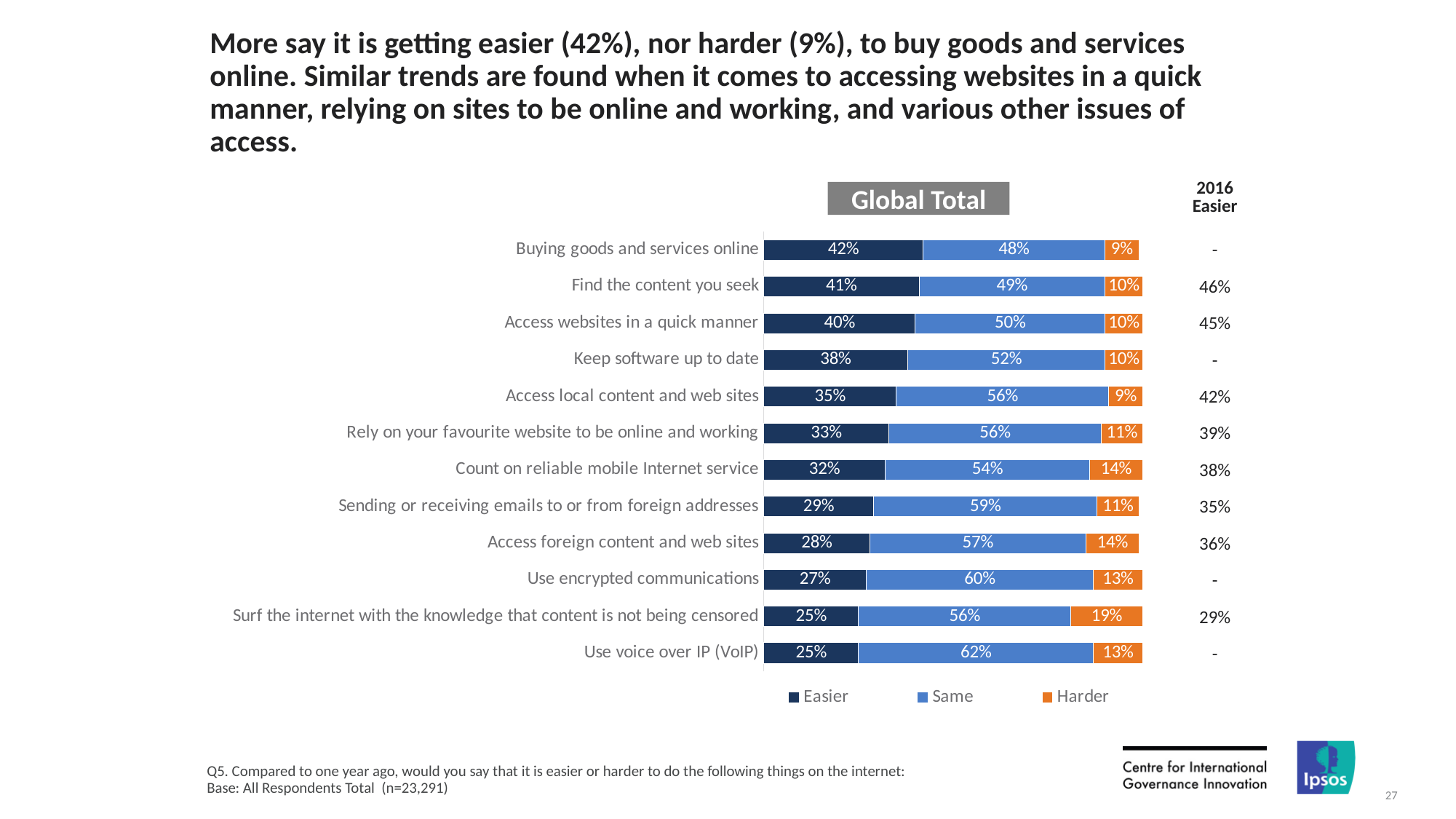
What is the 'Same' value for 'Use voice over IP (VoIP)'? 62% Which category has the highest 'Easier' value? Buying goods and services online What is the difference between the 'Easier' and 'Harder' values for 'Count on reliable mobile Internet service'? 18% How many series does the legend list? 3 What is the title shown above the chart? Global Total Which category has the highest 'Harder' value? Surf the internet with the knowledge that content is not being censored What percentage of respondents say it is easier to buy goods and services online? 42% What kind of chart is shown on the slide? Stacked bar chart What is the 'Harder' value for 'Surf the internet with the knowledge that content is not being censored'? 19% Which is larger: the 'Easier' value for 'Keep software up to date' or for 'Access local content and web sites'? Keep software up to date How many categories are shown in the chart? 12 What is the total of the stacked bar for 'Access foreign content and web sites'? 99%